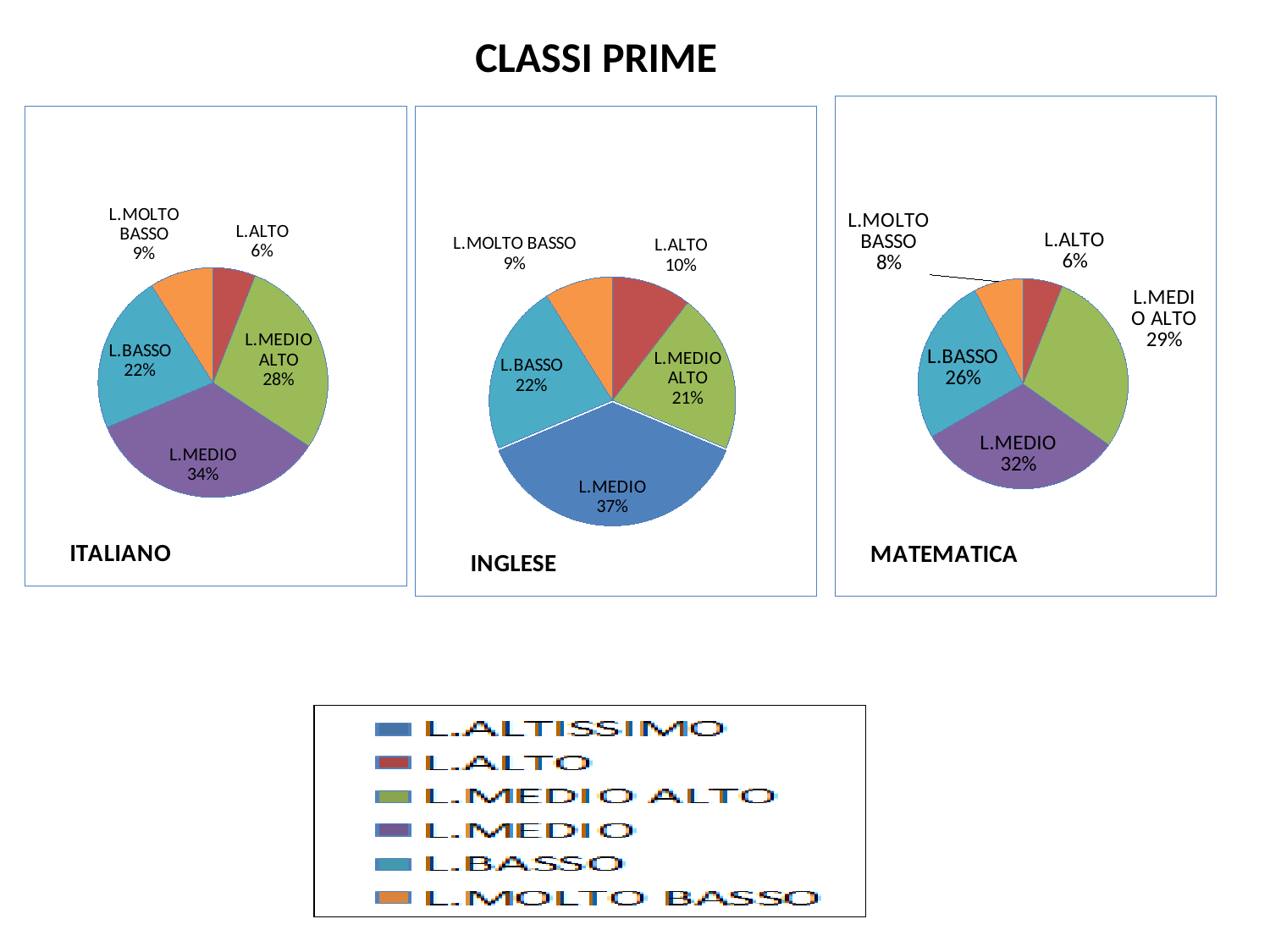
How many entries does the legend at the bottom of the slide list? 6 In the INGLESE chart, what share does L.MEDIO ALTO have? 21% In the MATEMATICA chart, which category has the smallest slice? L.ALTO What type of chart is used for MATEMATICA? Pie chart In the INGLESE chart, what is the difference between the L.MEDIO share and the L.BASSO share? 15% In the ITALIANO chart, is the L.MEDIO ALTO share larger or smaller than the L.BASSO share? larger In the ITALIANO chart, what share does L.MEDIO have? 34% In the MATEMATICA chart, what share does L.BASSO have? 26% In the MATEMATICA chart, what is the difference between the L.MEDIO share and the L.MEDIO ALTO share? 3% Which is larger: the L.ALTO share in the INGLESE chart or the L.ALTO share in the ITALIANO chart? INGLESE In the ITALIANO chart, which category has the largest slice? L.MEDIO How many slices are shown in the INGLESE pie chart? 5